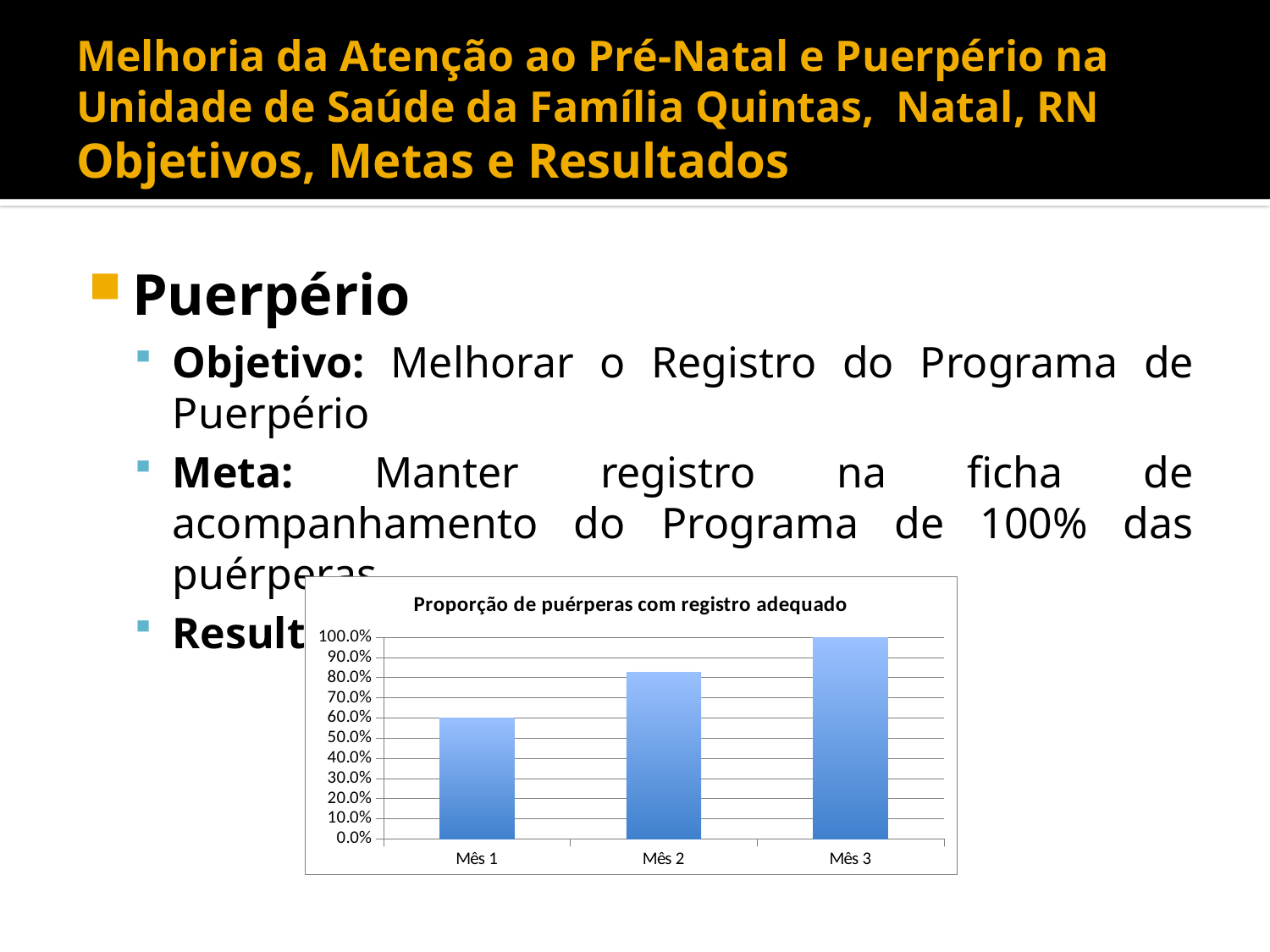
How many categories (months) are plotted in the chart? 3 Which is larger, the value for Mês 1 or the value for Mês 2? Mês 2 Is the value for Mês 3 greater or less than 90.0%? greater What is the maximum value shown on the vertical axis of the chart? 100.0% Which month has the highest proportion of puérperas com registro adequado? Mês 3 Which month has the lowest proportion of puérperas com registro adequado? Mês 1 What is the title of the chart on the slide? Proporção de puérperas com registro adequado Is the value for Mês 2 greater or less than 90.0%? less Do the values rise or fall from Mês 1 to Mês 3? rise What type of chart is shown on the slide? bar chart Is the value for Mês 1 greater or less than 70.0%? less